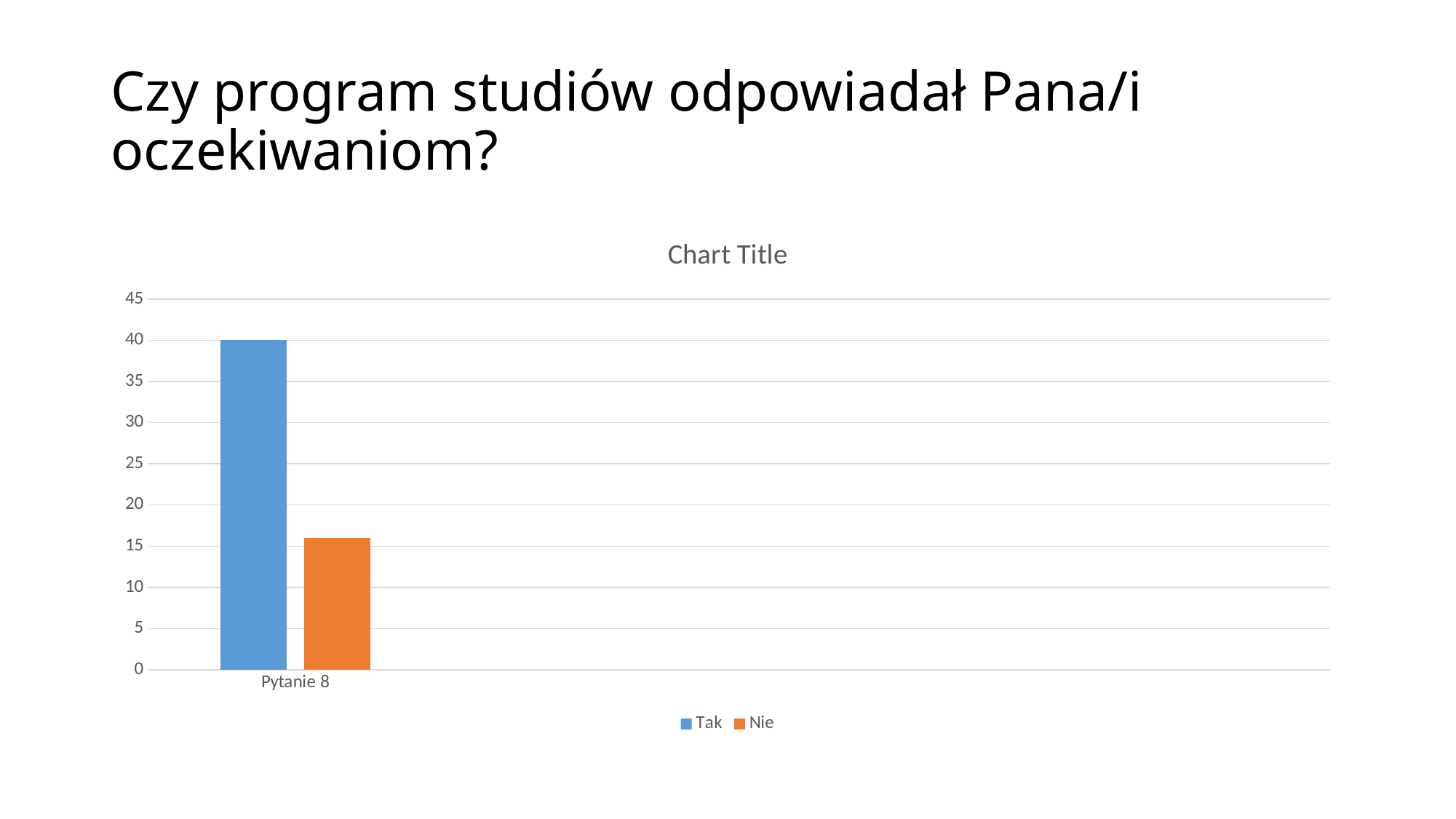
Which series has the lowest value in the chart? Nie Is the value of the Nie bar for Pytanie 8 greater or less than 20? less Which is larger for Pytanie 8, Tak or Nie? Tak What colour is the Nie series in the chart? orange Which series has the highest value in the chart? Tak How many series does the legend list? 2 What is the value of the Tak bar for Pytanie 8? 40 Is the value of the Tak bar for Pytanie 8 greater or less than 35? greater How many categories are shown on the x axis? 1 What is the title shown above the chart? Chart Title What kind of chart is shown on the slide? bar chart